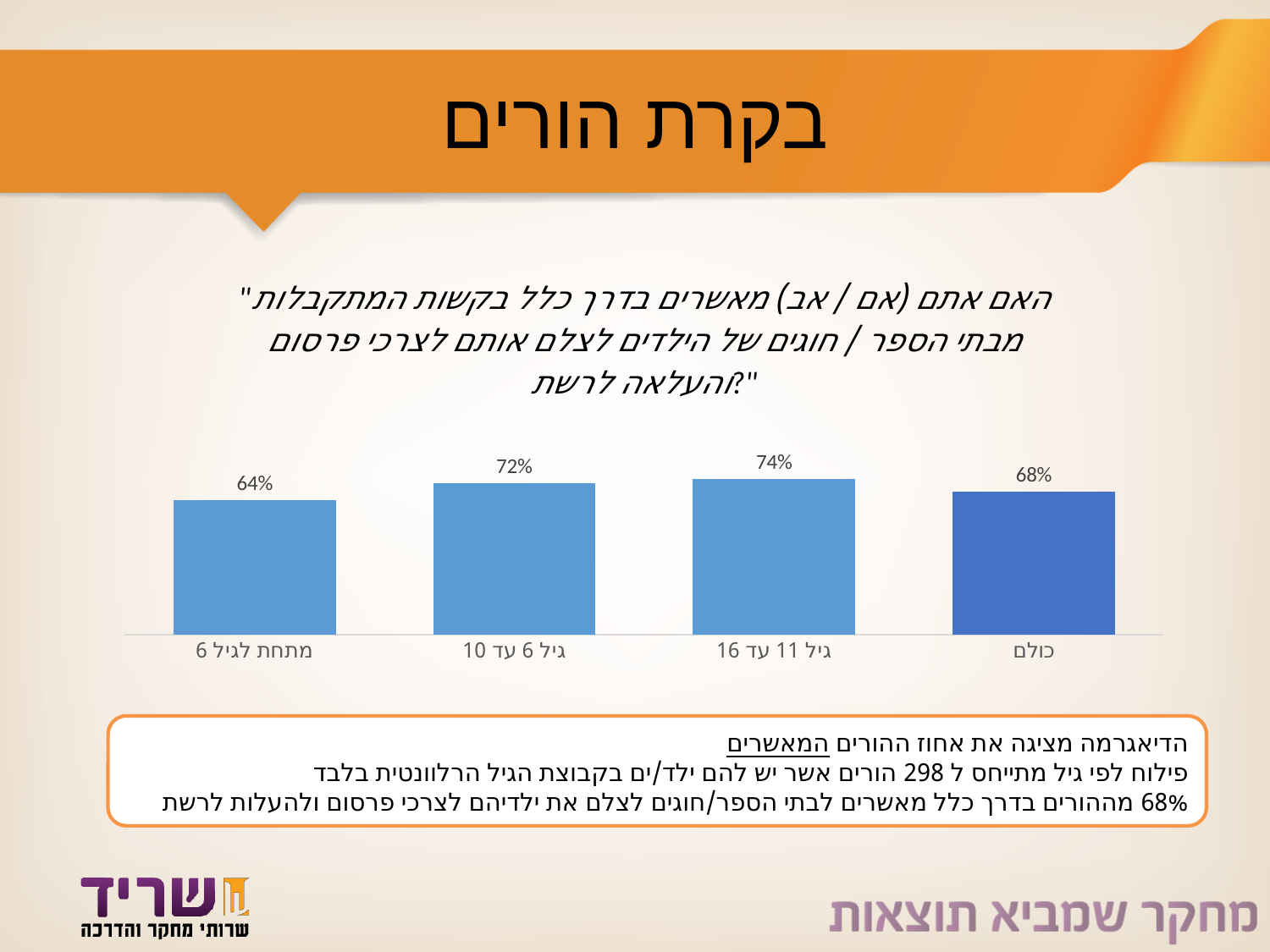
Which bar is shown in a darker shade of blue than the others? כולם Which category has the lowest value? מתחת לגיל 6 What kind of chart is shown on the slide? bar chart What is the difference between the values for "גיל 11 עד 16" and "מתחת לגיל 6"? 10% What is the value for the category "גיל 6 עד 10"? 72% What is the difference between the values for "גיל 6 עד 10" and "כולם"? 4% Which is larger, the value for "גיל 6 עד 10" or the value for "כולם"? גיל 6 עד 10 What is the value for the category "גיל 11 עד 16"? 74% What is the value for the category "מתחת לגיל 6"? 64% How many categories are shown in the chart? 4 Which category has the highest value? גיל 11 עד 16 What is the value for the category "כולם"? 68%